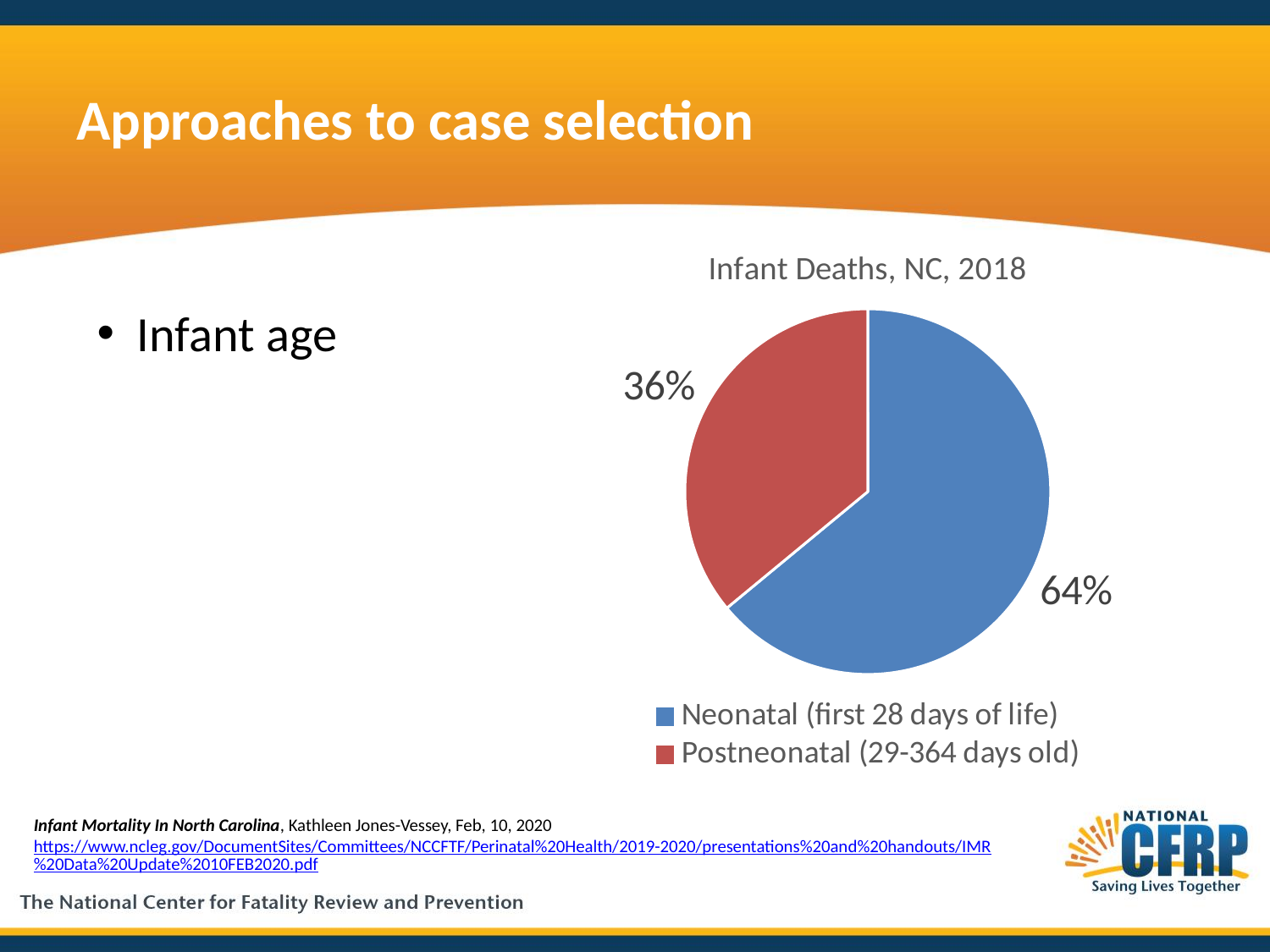
Which category has the smallest share of the pie? Postneonatal (29-364 days old) What is the difference in percentage points between the Neonatal and Postneonatal shares? 28 What colour is the Postneonatal (29-364 days old) slice? red What is the title of the chart? Infant Deaths, NC, 2018 How many entries does the legend list? 2 What share of infant deaths is Postneonatal (29-364 days old)? 36% What kind of chart is shown on the slide? pie chart What is the total of the two slice percentages shown? 100% How many slices does the pie chart have? 2 Which is larger, the Neonatal share or the Postneonatal share? Neonatal Which category has the largest share of the pie? Neonatal (first 28 days of life) What share of infant deaths is Neonatal (first 28 days of life)? 64%